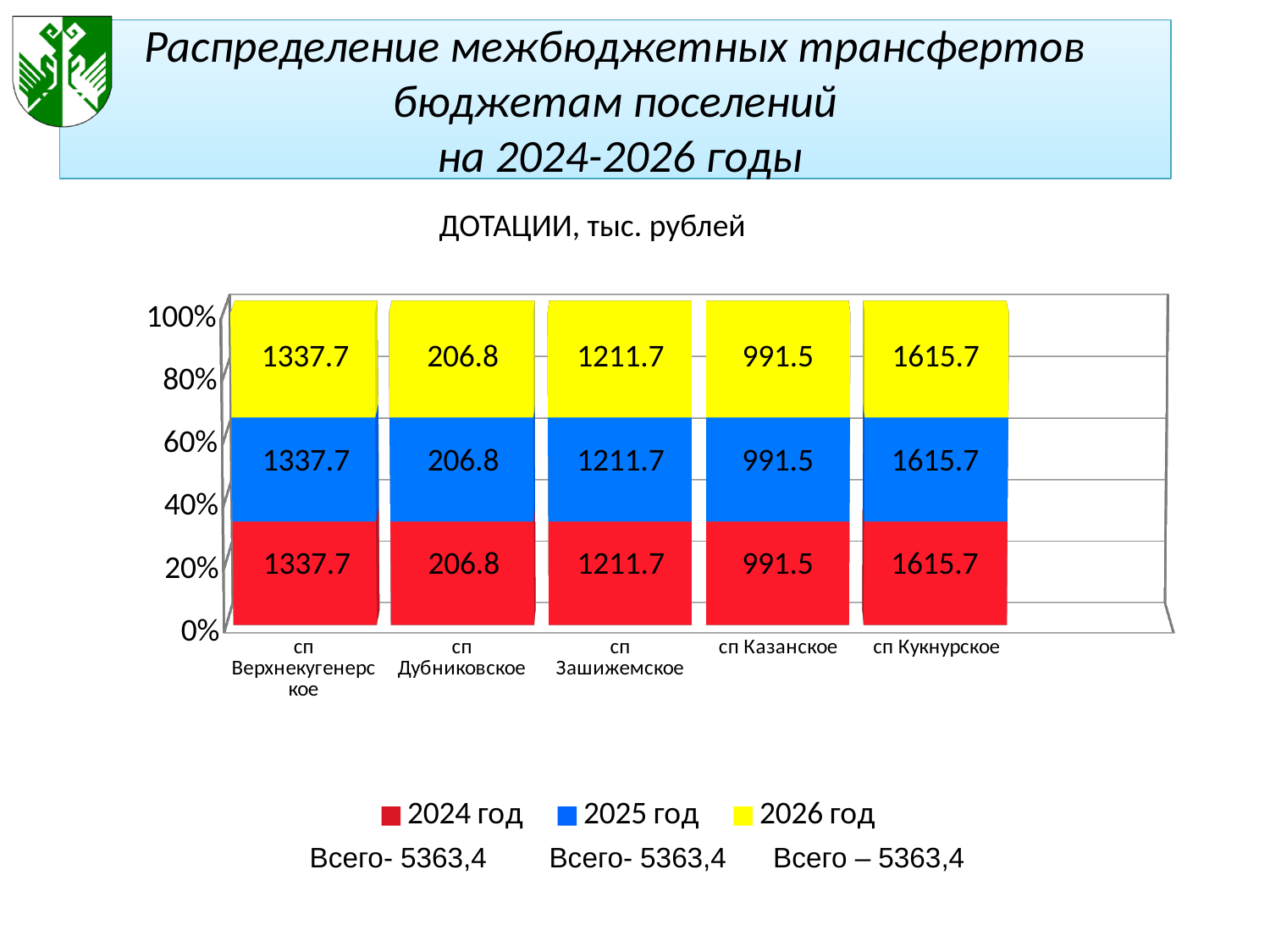
How many series does the legend list? 3 How many settlements are shown on the x axis of the chart? 5 What is the value for сп Казанское in the 2024 год series? 991.5 What is the total of the three stacked values for сп Дубниковское? 620.4 What is the value for сп Верхнекугенерское in the 2025 год series? 1337.7 Which settlement has the highest value in the 2025 год series? сп Кукнурское Which colour represents the 2026 год series in the legend? Yellow Which settlement has the lowest value in the 2024 год series? сп Дубниковское What kind of chart is shown on the slide? Stacked bar chart What is the difference between the 2024 год values for сп Кукнурское and сп Верхнекугенерское? 278.0 In the 2026 год series, which is larger: сп Зашижемское or сп Казанское? сп Зашижемское What is the value for сп Дубниковское in the 2026 год series? 206.8